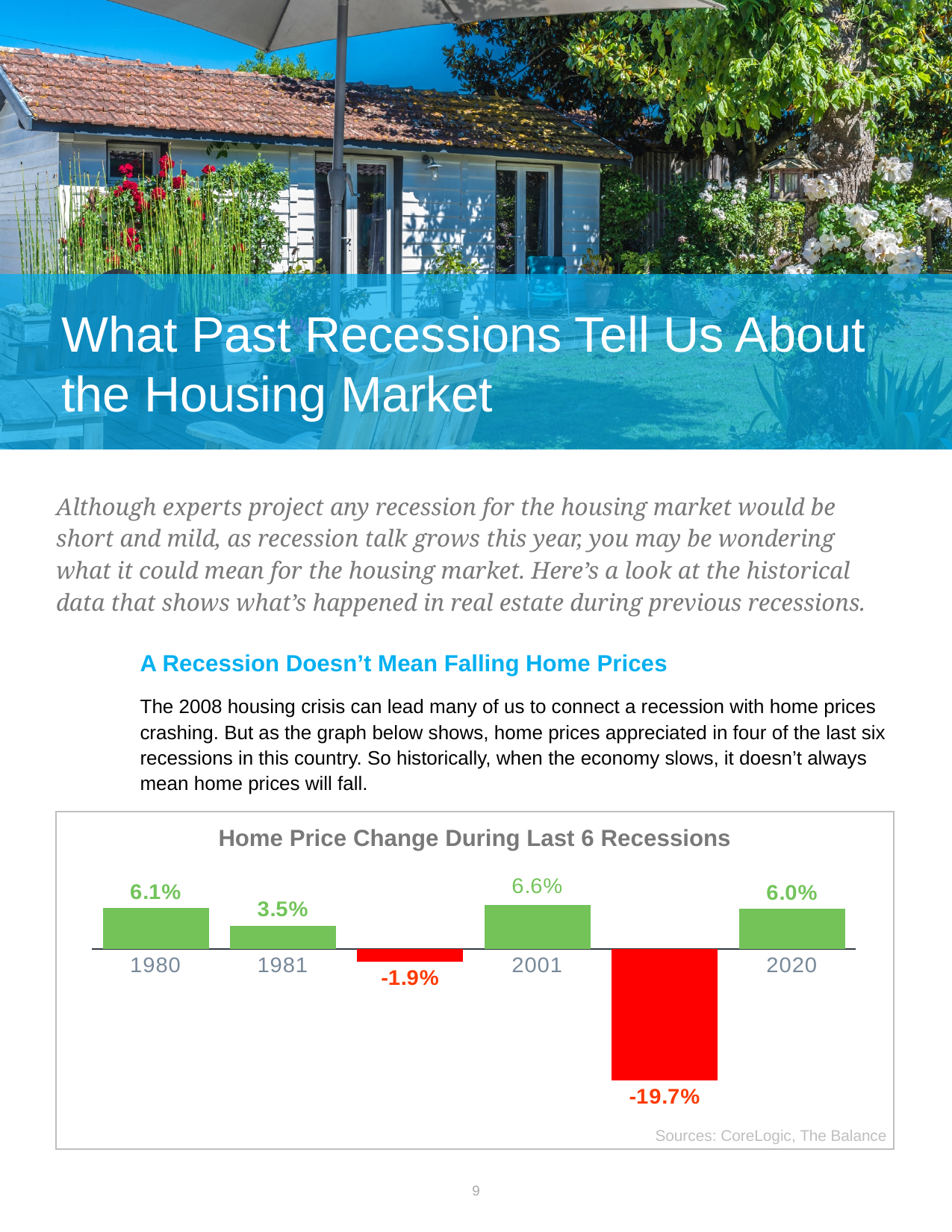
What type of chart is shown on the slide? Bar chart What is the lowest value shown in the chart? -19.7% What is the home price change shown for 2001? 6.6% Which is larger, the home price change for 1980 or for 2020? 1980 What is the home price change shown for 2020? 6.0% What is the difference between the home price change in 2001 and in 1981? 3.1% Which labeled year has the highest home price change in the chart? 2001 How many bars in the chart show a negative home price change? 2 How many bars are plotted in the chart? 6 What is the title of the chart? Home Price Change During Last 6 Recessions What is the home price change shown for 1980 in the Home Price Change During Last 6 Recessions chart? 6.1% What is the home price change shown for 1981? 3.5%